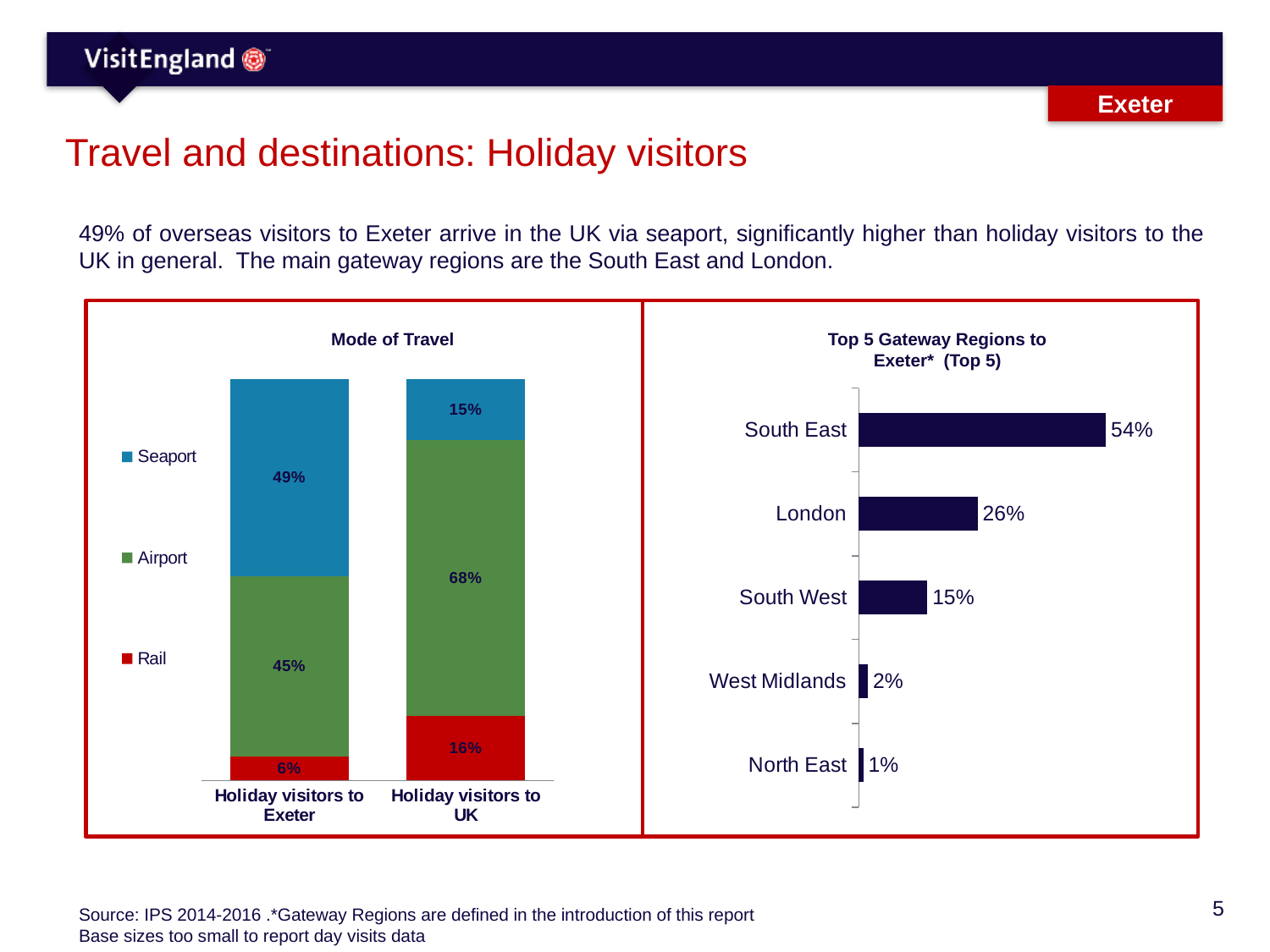
In the Top 5 Gateway Regions to Exeter chart, which region has the highest value? South East In the Mode of Travel chart, what percentage of holiday visitors to the UK arrive by airport? 68% In the Top 5 Gateway Regions to Exeter chart, what is the difference between South East and South West? 39 percentage points In the Mode of Travel chart, what is the difference between the seaport share for holiday visitors to Exeter and for holiday visitors to the UK? 34 percentage points In the Mode of Travel chart, which group has the larger airport share: holiday visitors to Exeter or holiday visitors to the UK? Holiday visitors to UK In the Top 5 Gateway Regions to Exeter chart, which region has the lowest value? North East In the Mode of Travel chart, what percentage of holiday visitors to Exeter arrive by seaport? 49% In the Mode of Travel chart, how many series does the legend list? 3 In the Top 5 Gateway Regions to Exeter chart, what is the value for London? 26% What kind of chart is the Top 5 Gateway Regions to Exeter chart? Bar chart In the Mode of Travel chart, what is the total of the stacked bar for holiday visitors to Exeter? 100% In the Mode of Travel chart, what is the rail share for holiday visitors to Exeter? 6%